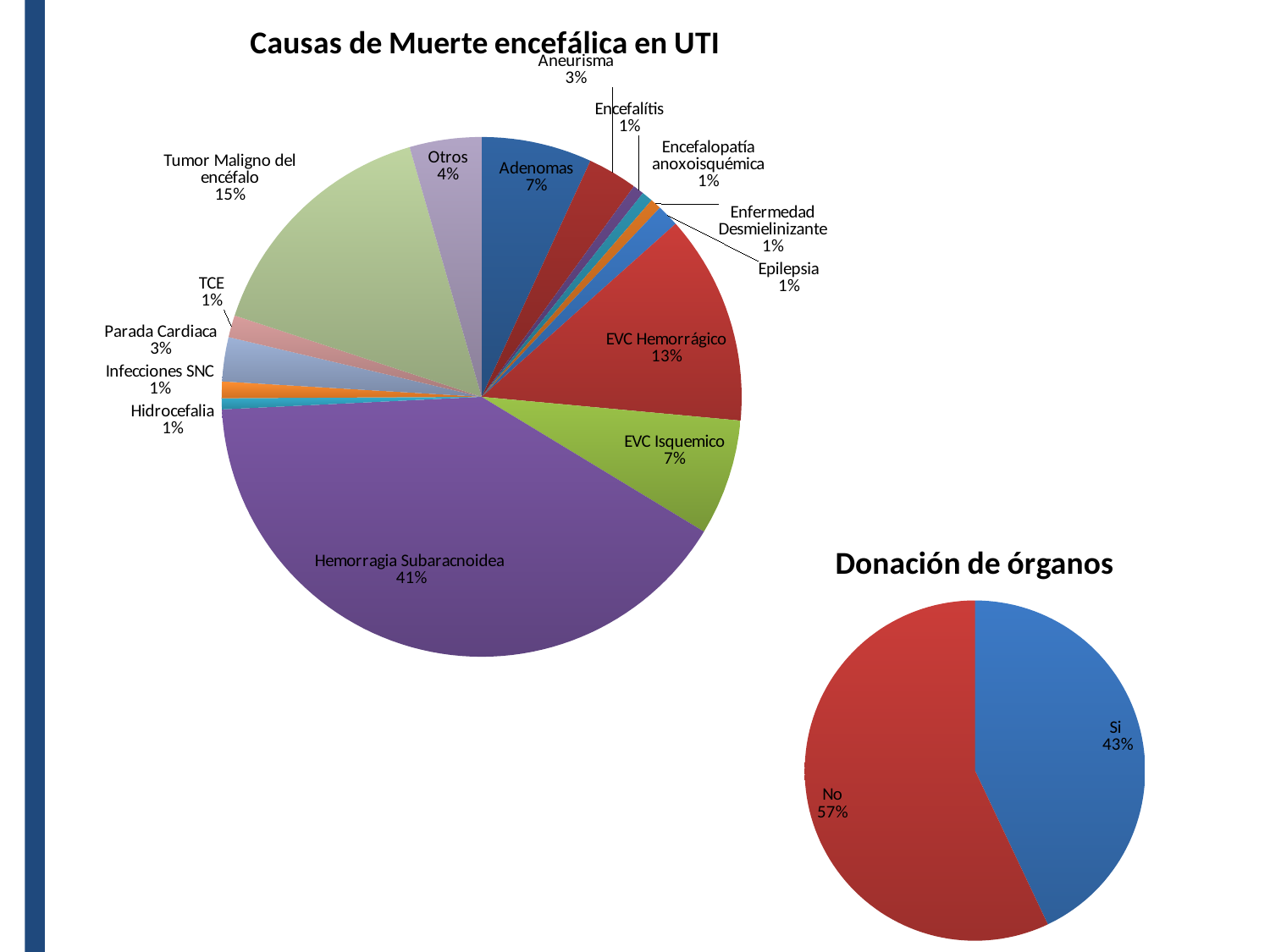
In the 'Donación de órganos' chart, what is the difference between 'No' and 'Si'? 14% In the 'Donación de órganos' chart, what share is 'No'? 57% What is the title of the chart in the lower right of the slide? Donación de órganos In the 'Donación de órganos' chart, what is the value for 'Si'? 43% In the 'Causas de Muerte encefálica en UTI' chart, what share does Hemorragia Subaracnoidea have? 41% In the 'Causas de Muerte encefálica en UTI' chart, which is larger, Adenomas or Otros? Adenomas In the 'Causas de Muerte encefálica en UTI' chart, which cause has the largest share? Hemorragia Subaracnoidea In the 'Causas de Muerte encefálica en UTI' chart, what is the difference between Tumor Maligno del encéfalo and EVC Hemorrágico? 2% In the 'Causas de Muerte encefálica en UTI' chart, how many categories are shown? 15 In the 'Causas de Muerte encefálica en UTI' chart, what is the value for EVC Hemorrágico? 13% In the 'Causas de Muerte encefálica en UTI' chart, what is the value for Tumor Maligno del encéfalo? 15% What kind of chart is 'Causas de Muerte encefálica en UTI'? Pie chart